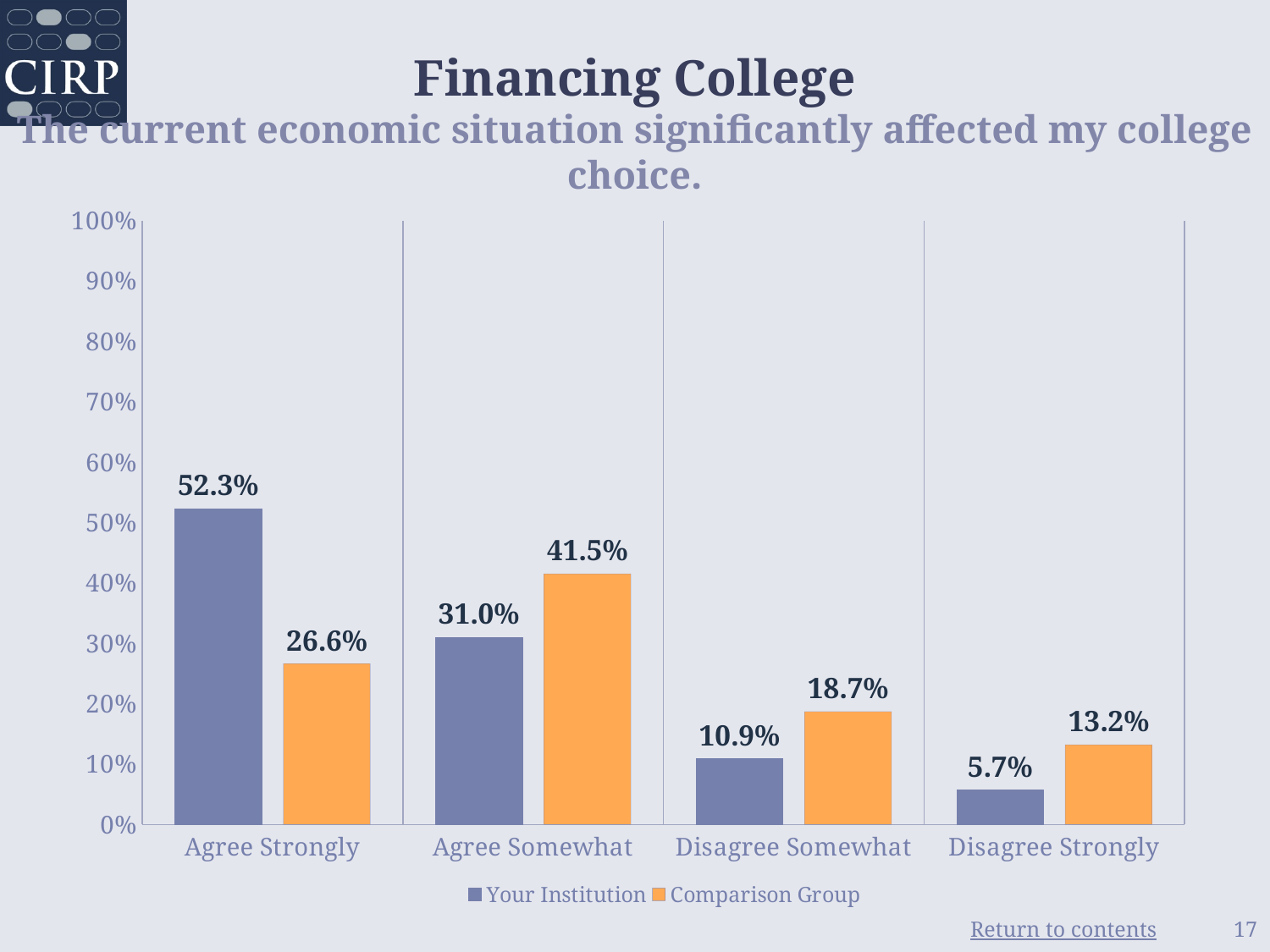
What is the value for Comparison Group in the Agree Somewhat category? 41.5% How many categories are shown on the x axis? 4 Which category has the lowest value for Your Institution? Disagree Strongly Which colour represents the Comparison Group series? orange Which category has the highest value for Comparison Group? Agree Somewhat What is the difference between Your Institution and Comparison Group in the Agree Strongly category? 25.7% What is the value for Your Institution in the Agree Strongly category? 52.3% Which is larger in the Disagree Somewhat category, Your Institution or Comparison Group? Comparison Group What kind of chart is shown on the slide? bar chart Is the value for Comparison Group in the Agree Strongly category greater or less than 30%? less What is the value for Your Institution in the Disagree Strongly category? 5.7% How many series does the legend list? 2